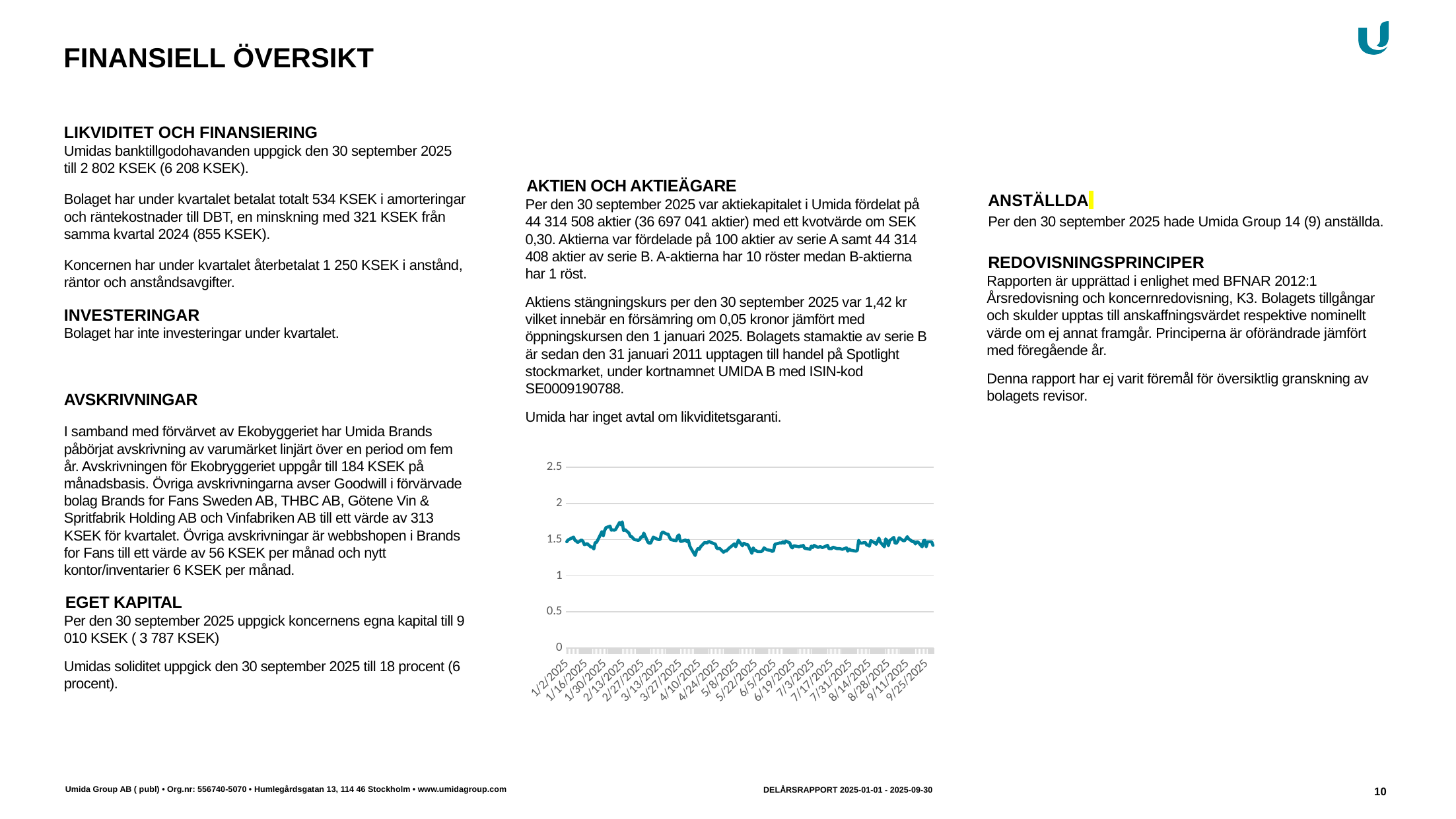
Is the value of the line at 9/25/2025 greater or less than 2? less Is the value of the line at 1/2/2025 greater or less than 1? greater What is the highest tick value shown on the y axis of the chart? 2.5 What is the first date label shown on the x axis of the chart? 1/2/2025 How many lines (series) are plotted in the chart? 1 What kind of chart is shown on the slide? line chart Is the highest point of the line greater or less than 1.5? greater Does the line reach its peak in the early part (around February) or the late part (around September) of the x axis? early part (around February)